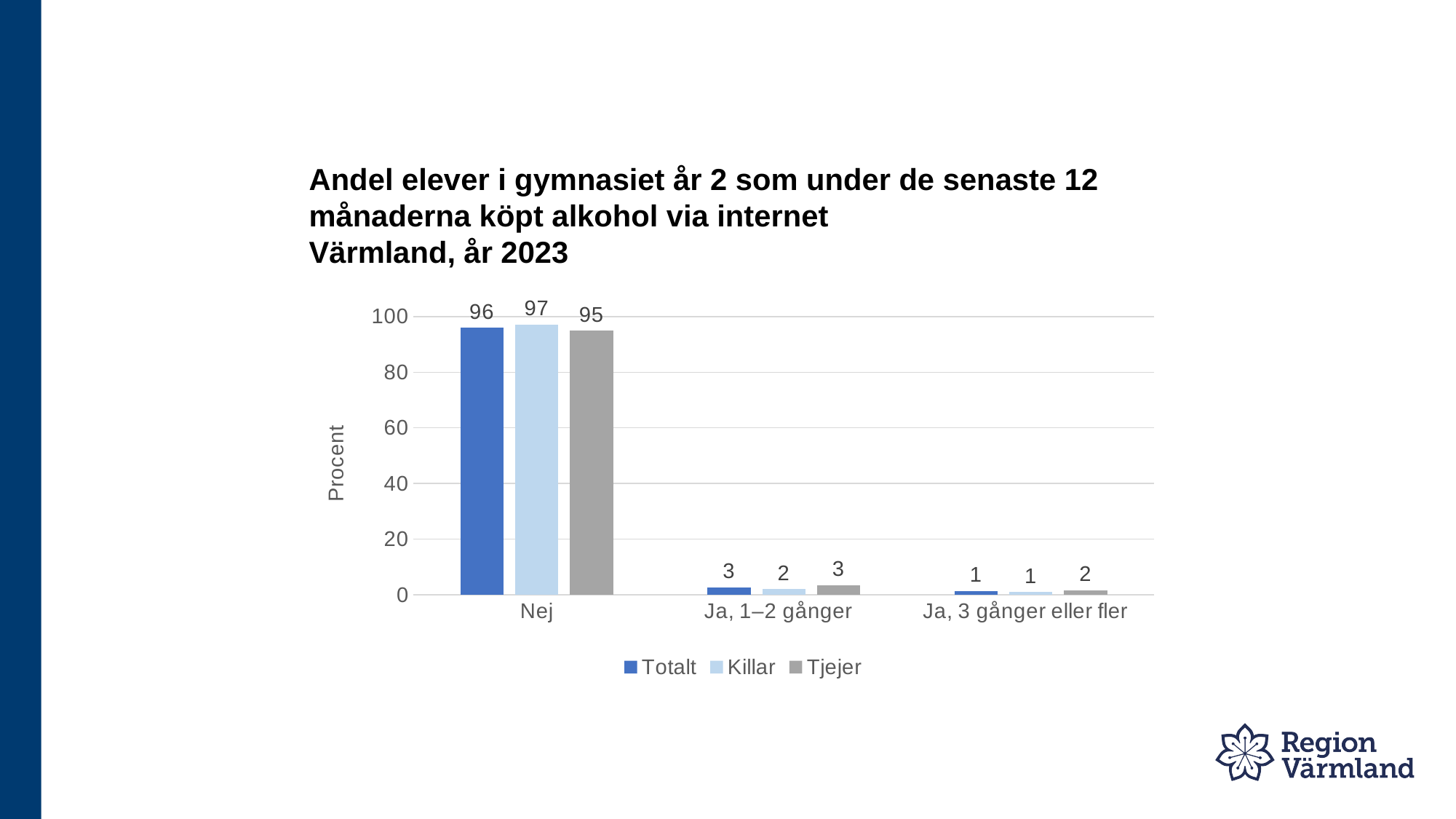
How many categories are shown on the x axis? 3 What is the difference between the Killar and Tjejer values in the Nej category? 2 In the Nej category, which series has the larger value, Killar or Tjejer? Killar What is the value for Killar in the Ja, 1–2 gånger category? 2 Which category has the lowest value for Tjejer? Ja, 3 gånger eller fler How many series does the legend list? 3 What is the value for Tjejer in the Ja, 3 gånger eller fler category? 2 What is the label of the y axis? Procent What is the value for Killar in the Nej category? 97 Which category has the highest value for Totalt? Nej What is the value for Totalt in the Nej category? 96 What kind of chart is shown on the slide? Bar chart